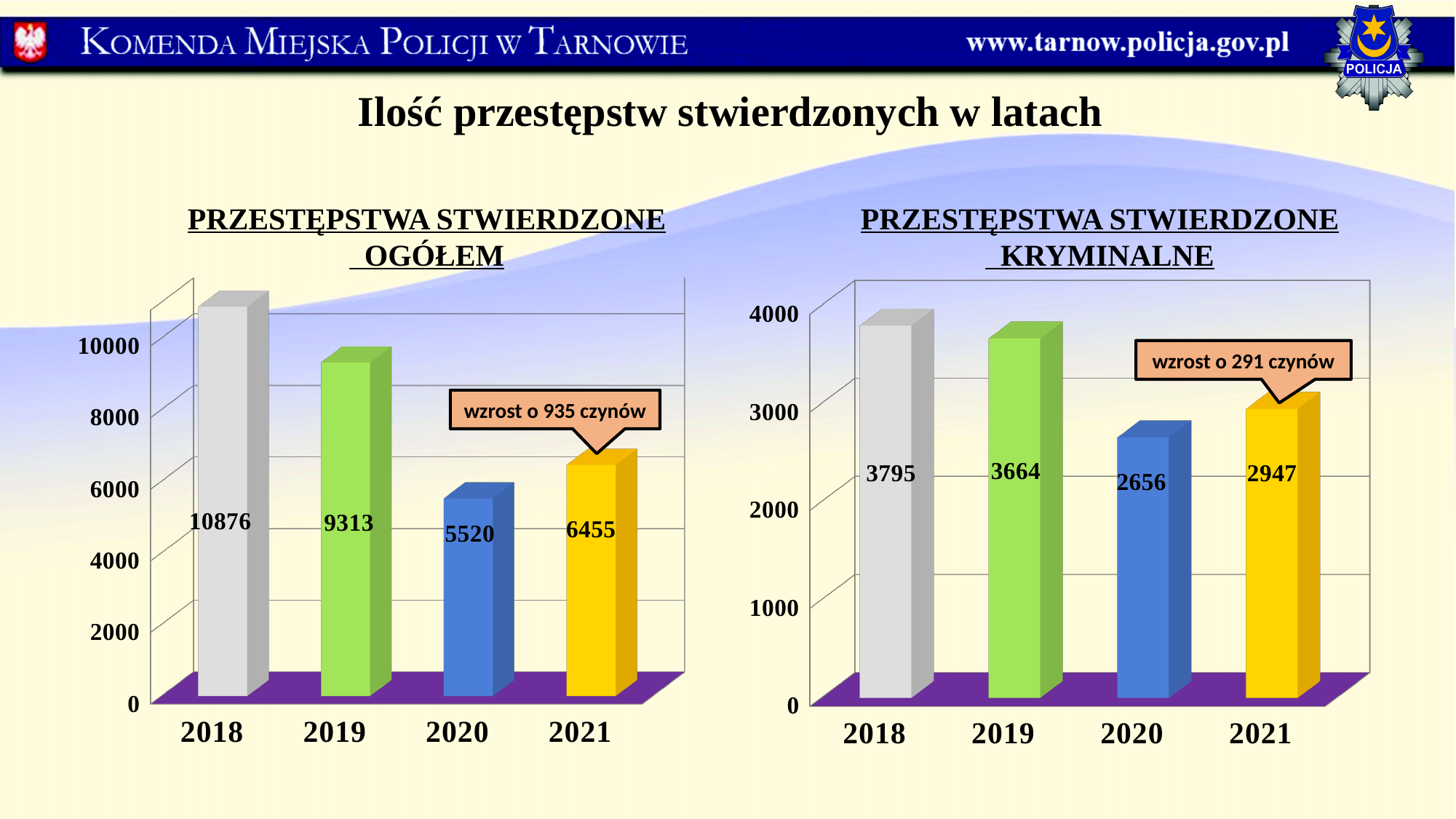
In the 'PRZESTĘPSTWA STWIERDZONE OGÓŁEM' chart, what is the value for 2018? 10876 In the 'PRZESTĘPSTWA STWIERDZONE OGÓŁEM' chart, which is larger, the value for 2019 or the value for 2021? 2019 In the 'PRZESTĘPSTWA STWIERDZONE KRYMINALNE' chart, which year has the highest value? 2018 How many years are shown in the 'PRZESTĘPSTWA STWIERDZONE OGÓŁEM' chart? 4 What does the callout on the 'PRZESTĘPSTWA STWIERDZONE KRYMINALNE' chart say? wzrost o 291 czynów In the 'PRZESTĘPSTWA STWIERDZONE KRYMINALNE' chart, what is the difference between the 2018 and 2019 values? 131 What kind of chart is the 'PRZESTĘPSTWA STWIERDZONE KRYMINALNE' chart? bar chart In the 'PRZESTĘPSTWA STWIERDZONE OGÓŁEM' chart, which year has the lowest value? 2020 In the 'PRZESTĘPSTWA STWIERDZONE KRYMINALNE' chart, is the value for 2021 greater or less than 3000? less In the 'PRZESTĘPSTWA STWIERDZONE KRYMINALNE' chart, what is the value for 2020? 2656 In the 'PRZESTĘPSTWA STWIERDZONE OGÓŁEM' chart, do the values rise or fall from 2018 to 2020? fall In the 'PRZESTĘPSTWA STWIERDZONE OGÓŁEM' chart, what is the difference between the 2021 and 2020 values? 935